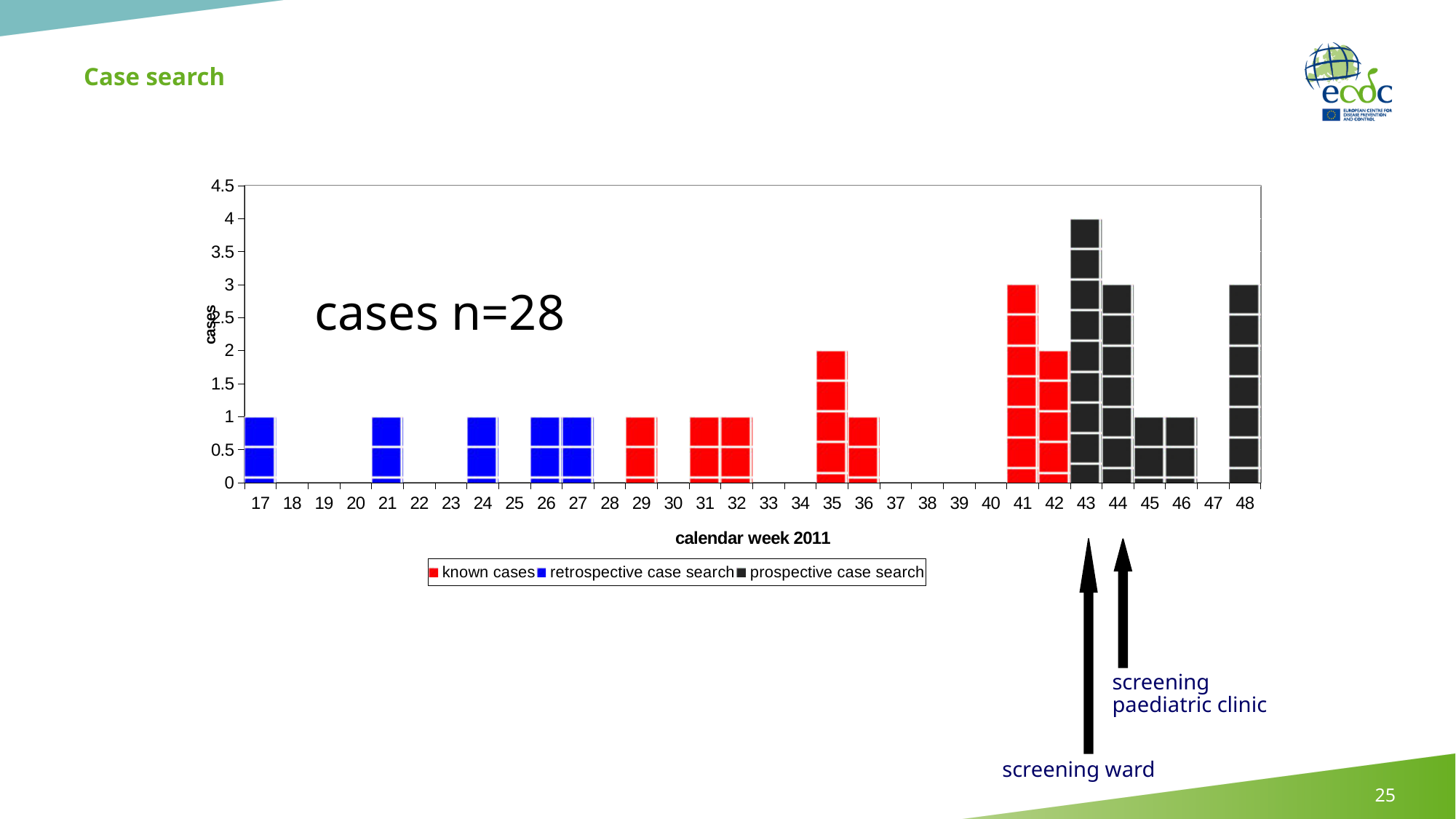
What kind of chart is shown on the slide? bar chart What is the label of the x axis? calendar week 2011 How many cases are shown for calendar week 35? 2 How many series does the legend list? 3 How many cases are shown for calendar week 41? 3 Which series does the bar for calendar week 17 belong to, according to the legend? retrospective case search How many cases are shown for calendar week 43? 4 How many cases are shown for calendar week 48? 3 Which has more cases, calendar week 41 or calendar week 42? 41 Which calendar week has the highest number of cases? 43 Is the value for calendar week 43 greater or less than 3.5? greater What is the difference in cases between calendar week 43 and calendar week 44? 1